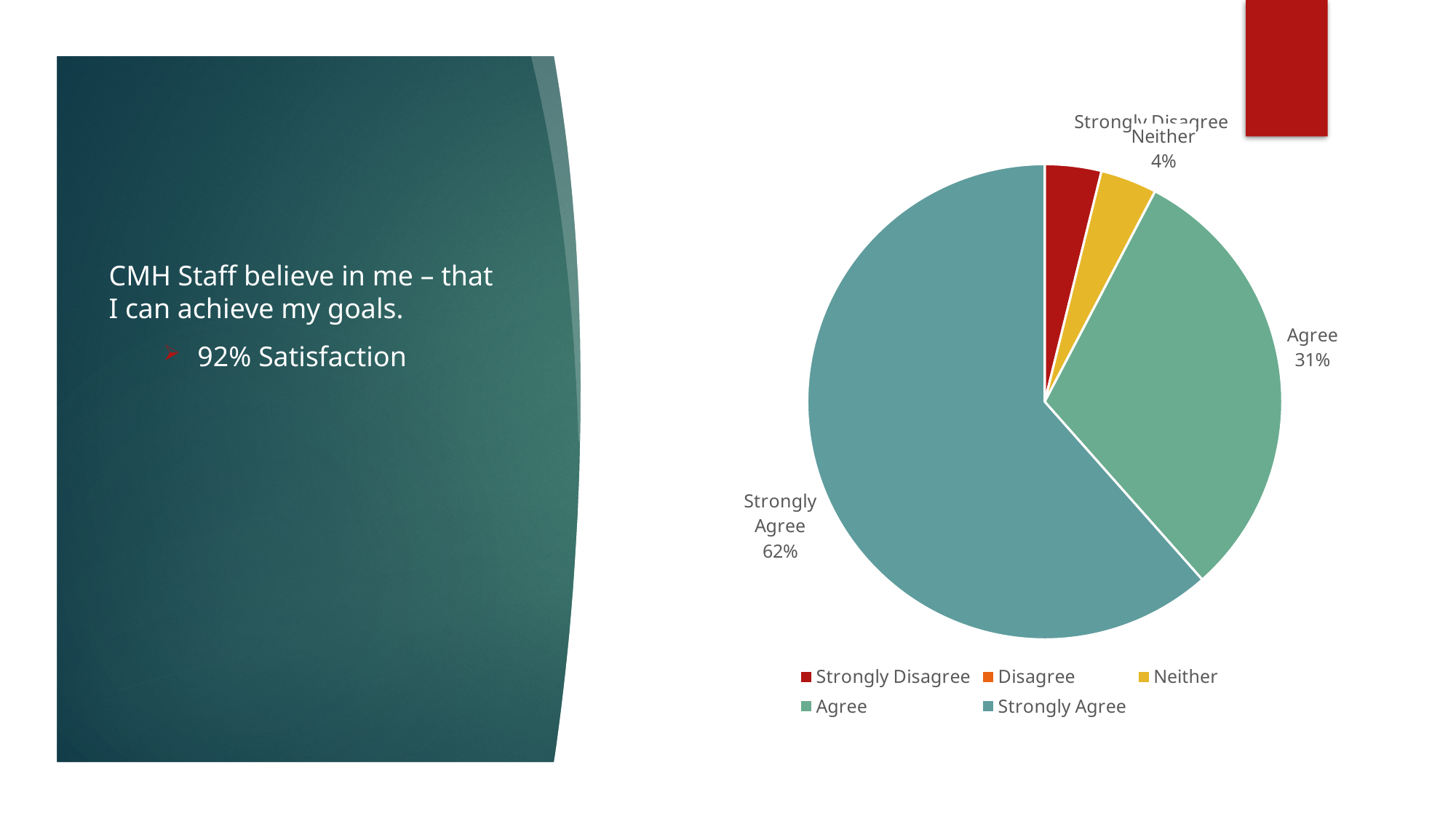
What type of chart is shown on the slide? Pie chart What colour is the Strongly Disagree slice? Red Which is larger, the share for Agree or the share for Strongly Agree? Strongly Agree Which response category has the largest share of the pie? Strongly Agree What percentage of respondents chose Agree? 31% What percentage of respondents chose Strongly Agree? 62% What is the difference in percentage points between Strongly Agree and Agree? 31 percentage points Is the share for Strongly Agree greater or less than 50%? greater How many response categories does the legend list? 5 Which legend entry does not have a visible slice in the pie? Disagree How many slices are visible in the pie chart? 4